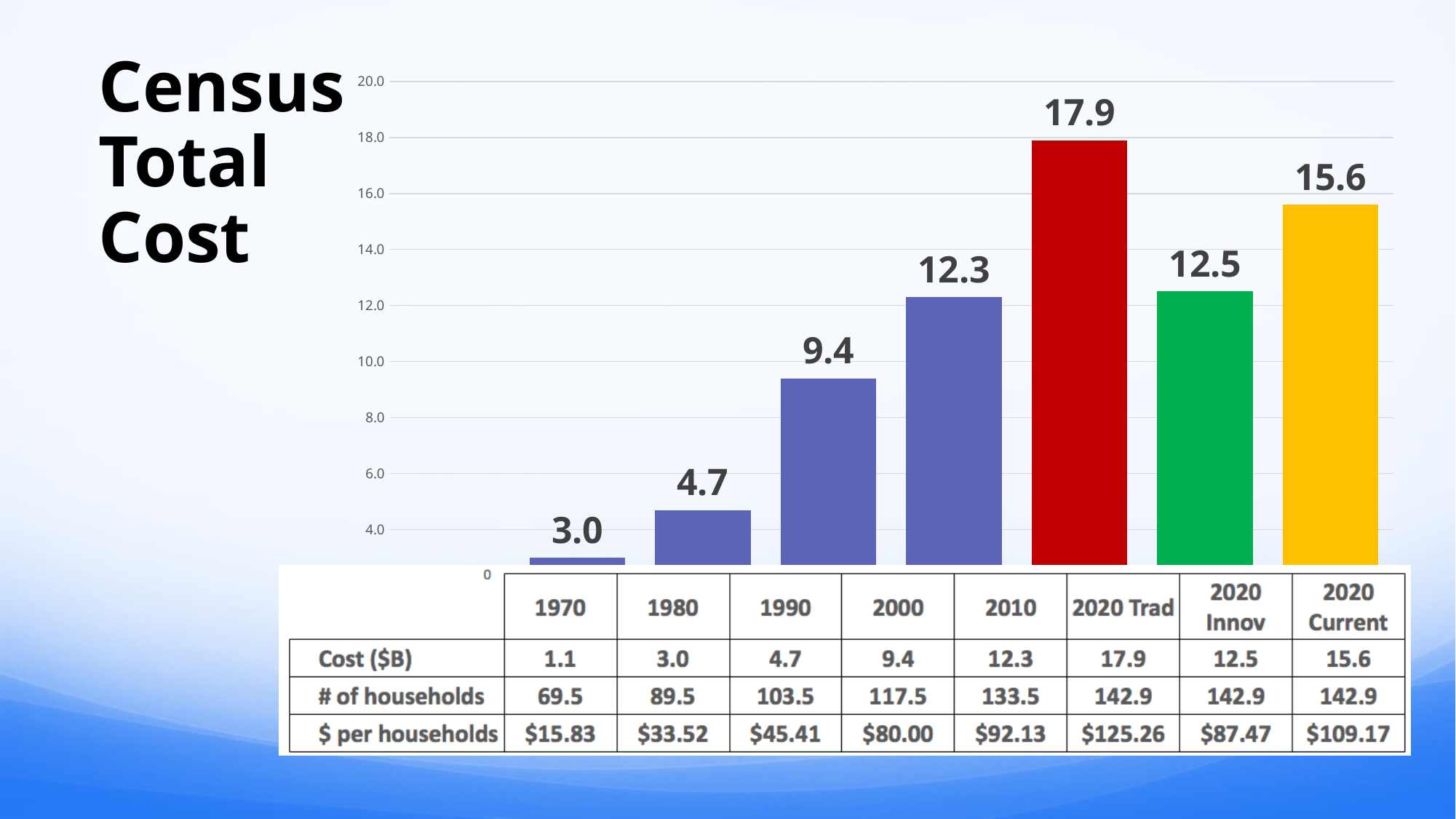
What is the # of households value for 2010? 133.5 Which category has the lowest Cost ($B) in the table? 1970 What is the difference in Cost ($B) between 2020 Trad and 2020 Current? 2.3 Is the tallest bar's value greater or less than 16.0? greater What is the $ per households value for 2020 Innov? $87.47 Which category has the highest Cost ($B)? 2020 Trad Which has a higher Cost ($B), 2020 Innov or 2020 Current? 2020 Current What colour is the tallest bar in the chart? red What kind of chart is shown on the slide? bar chart What is the Cost ($B) for 2020 Trad? 17.9 What is the title of the slide's chart? Census Total Cost What is the Cost ($B) for 2020 Current? 15.6